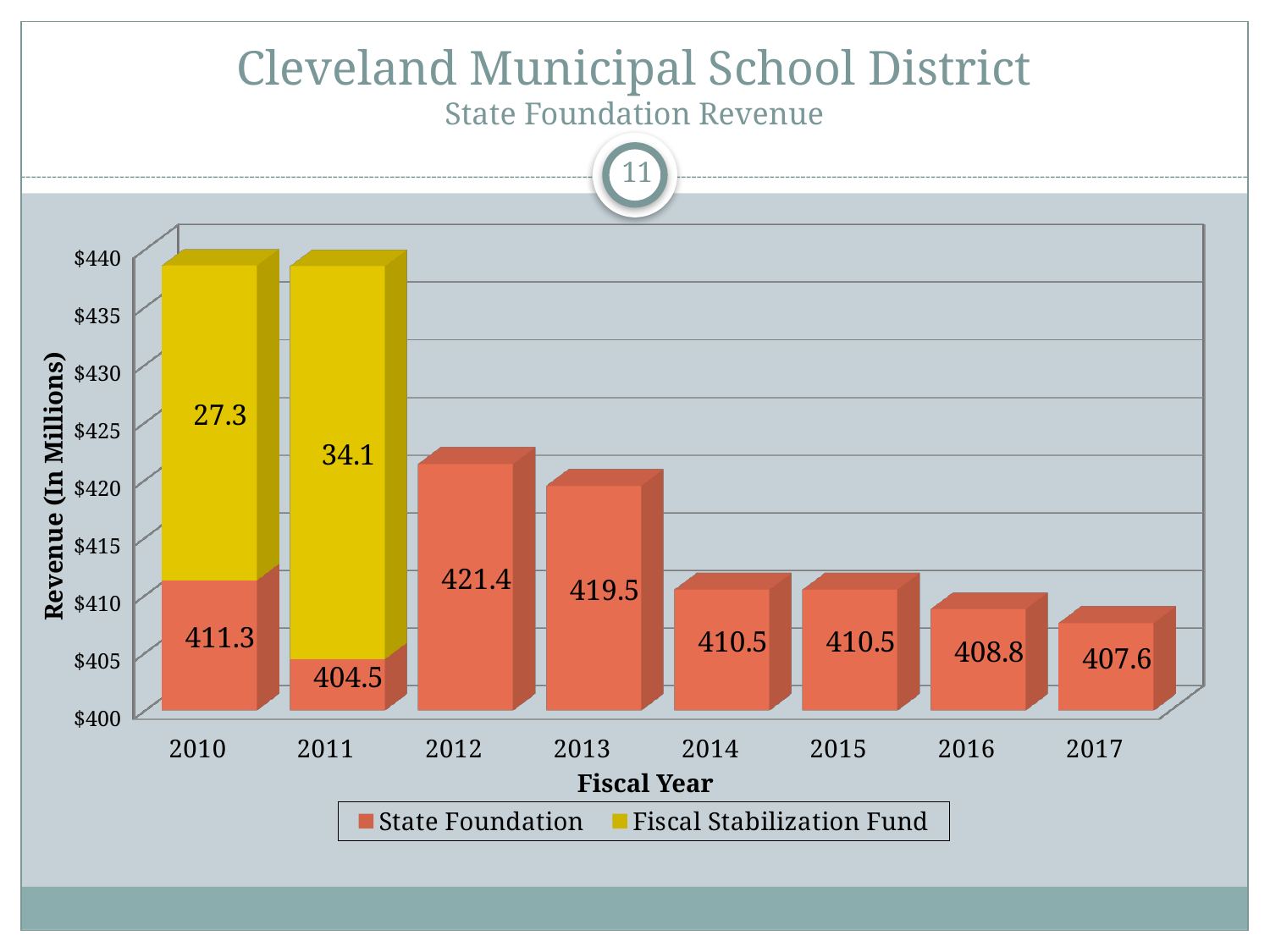
What is the State Foundation value for fiscal year 2012? 421.4 What is the Fiscal Stabilization Fund value for fiscal year 2011? 34.1 How many fiscal years are shown on the x axis? 8 Which fiscal year has the lowest State Foundation value? 2011 Which is larger, the Fiscal Stabilization Fund value for 2010 or for 2011? 2011 How many series does the legend list? 2 What is the State Foundation value for fiscal year 2017? 407.6 Do the State Foundation values rise or fall from 2013 to 2017? Fall What is the difference between the State Foundation values for 2012 and 2013? 1.9 What kind of chart is shown on the slide? Stacked bar chart What is the total of the stacked bar for fiscal year 2010? 438.6 Which fiscal year has the highest State Foundation value? 2012